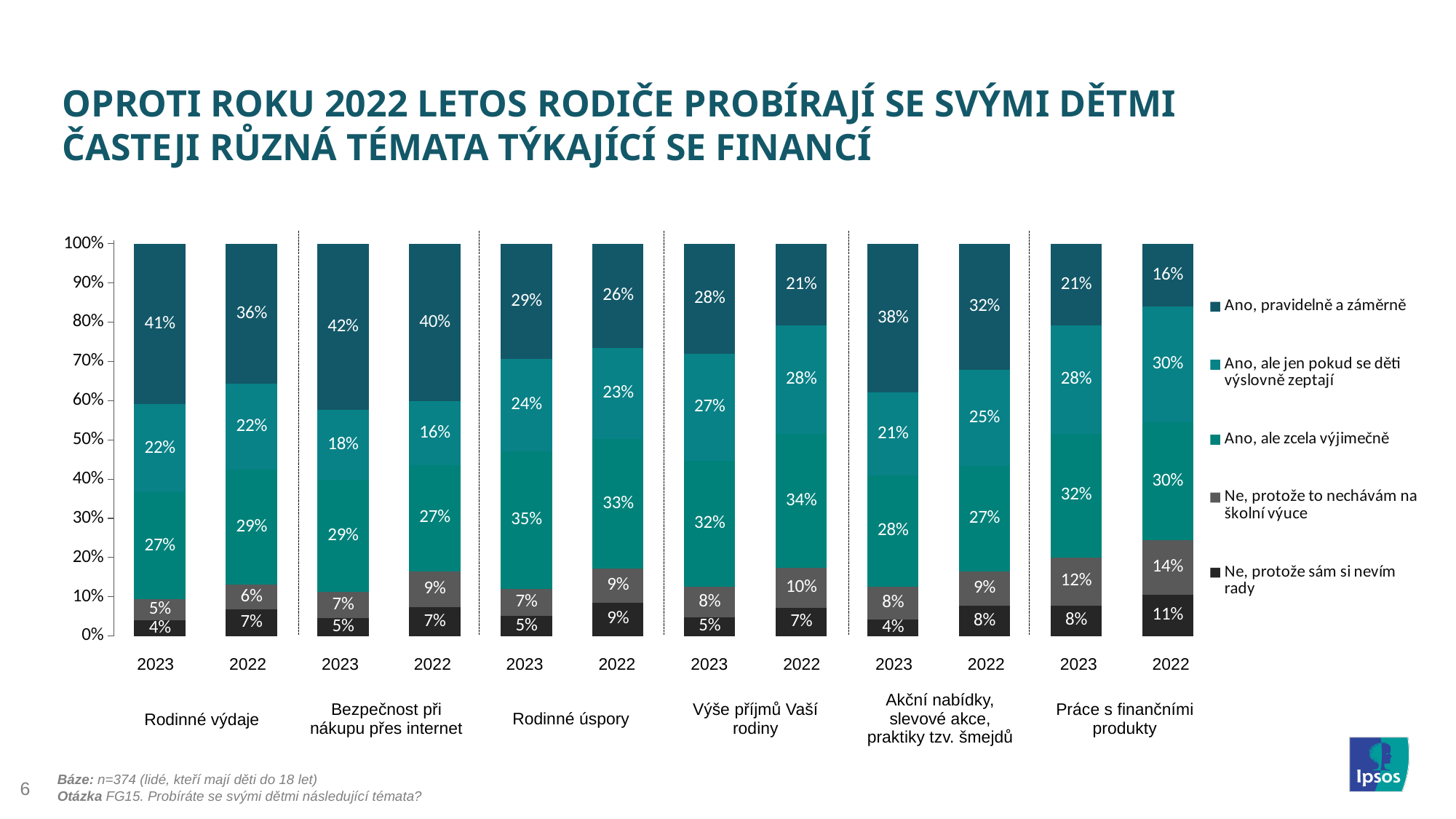
Which bar has the highest value for "Ano, pravidelně a záměrně"? Bezpečnost při nákupu přes internet, 2023 What is the difference between the "Ne, protože to nechávám na školní výuce" values for Práce s finančními produkty in 2022 and 2023? 2 percentage points How many series does the legend list? 5 What type of chart is shown on the slide? Stacked bar chart By how many percentage points did "Ano, pravidelně a záměrně" for Výše příjmů Vaší rodiny change from 2022 to 2023? 7 percentage points How many bars are plotted in the chart? 12 Which legend entry is shown in black? Ne, protože sám si nevím rady What share of parents answered "Ano, ale zcela výjimečně" for Rodinné úspory in 2023? 35% What is the value of "Ne, protože sám si nevím rady" for Práce s finančními produkty in 2022? 11% Which is larger: "Ano, pravidelně a záměrně" for Akční nabídky, slevové akce, praktiky tzv. šmejdů in 2023 or in 2022? 2023 Which bar has the lowest value for "Ano, pravidelně a záměrně"? Práce s finančními produkty, 2022 What share of parents answered "Ano, pravidelně a záměrně" for Rodinné výdaje in 2023? 41%